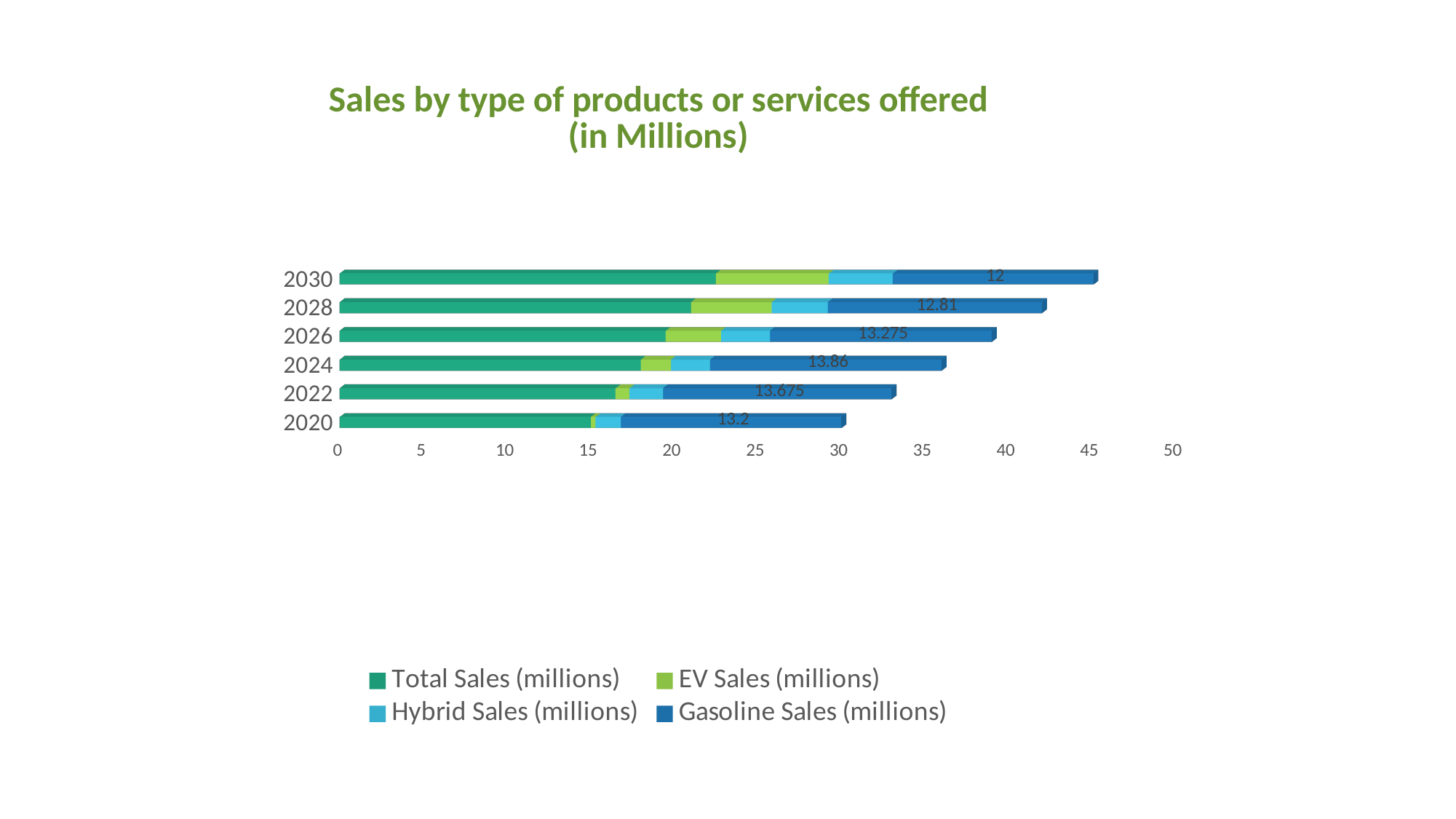
How many series does the legend list? 4 Which year has the lowest Gasoline Sales (millions) value? 2030 Is the Total Sales (millions) value for 2030 greater or less than 20? greater What is the Gasoline Sales (millions) value for 2026? 13.275 What is the Gasoline Sales (millions) value for 2020? 13.2 What is the Gasoline Sales (millions) value for 2024? 13.86 How many years are shown on the chart? 6 What kind of chart is shown on the slide? Stacked bar chart What is the Gasoline Sales (millions) value for 2030? 12 What is the difference between the Gasoline Sales (millions) values for 2024 and 2030? 1.86 Which year has the larger Gasoline Sales (millions) value, 2028 or 2026? 2026 Which year has the highest Gasoline Sales (millions) value? 2024